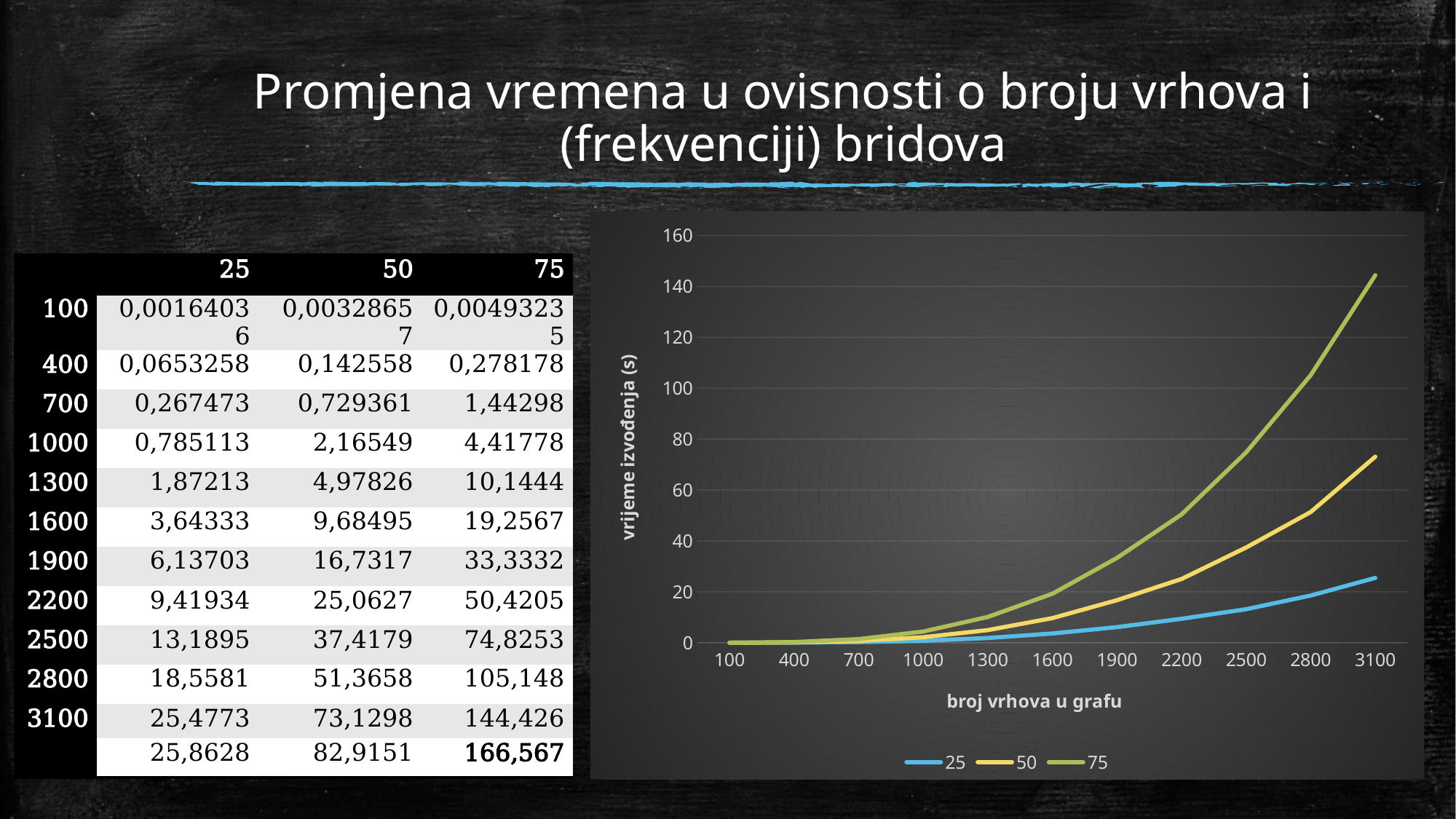
What kind of chart is shown on the slide? line chart Which series has the lowest value at 3100 on the chart? 25 What are the series names listed in the chart legend? 25, 50, 75 What is the title of the chart's x axis? broj vrhova u grafu How many points are plotted along the x axis of the chart? 11 Is the value of the 75 series at 3100 greater or less than 120? greater At 2800 on the x axis, which series has the larger value, 75 or 25? 75 How many series does the chart legend list? 3 Is the value of the 50 series at 3100 greater or less than 60? greater Which series reaches the highest value at 3100 on the chart? 75 Is the value of the 25 series at 3100 greater or less than 40? less Do the values of the 75 series rise or fall as the number of vertices increases along the x axis? rise